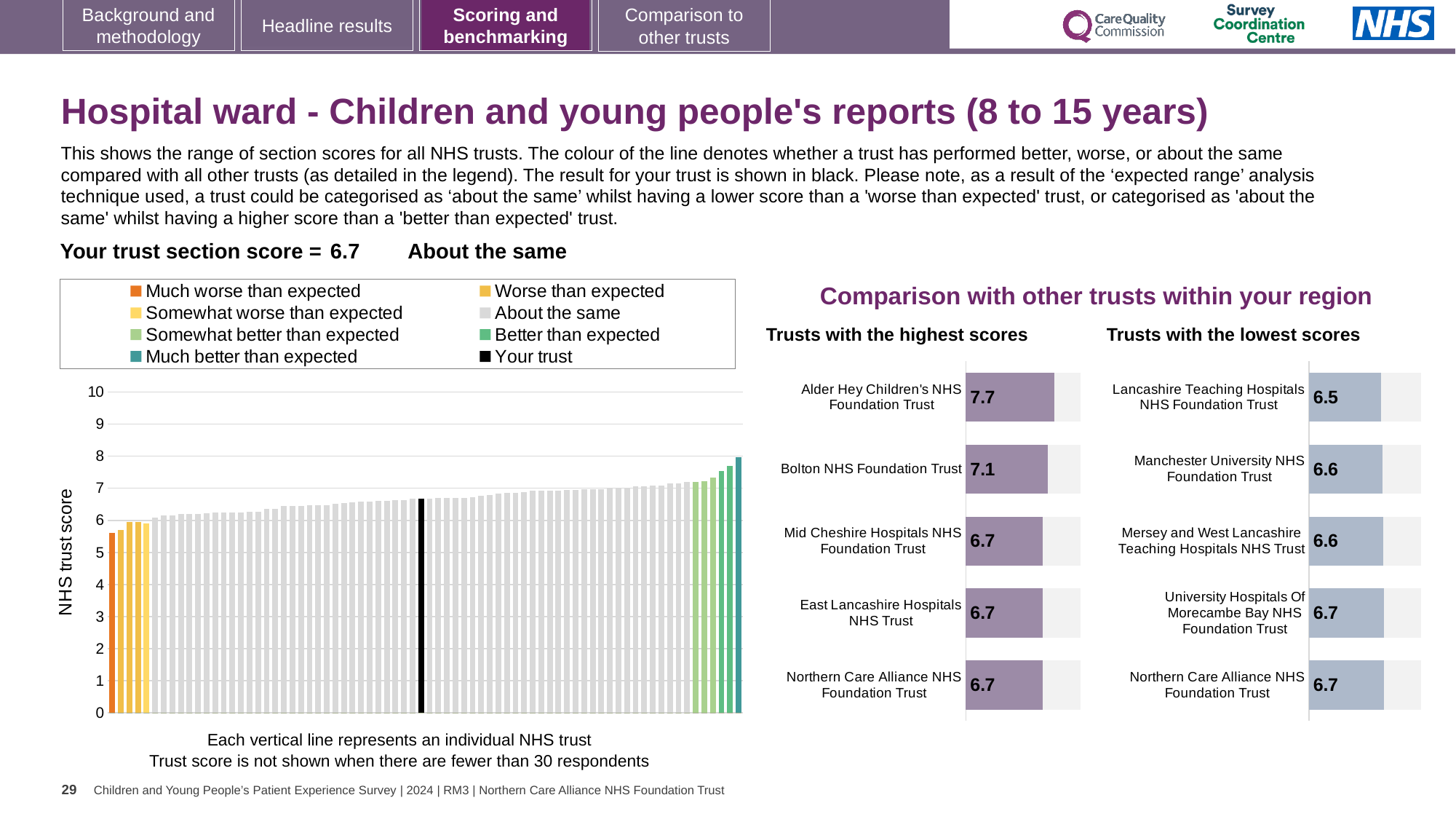
In the 'Trusts with the lowest scores' chart, what is the score for Manchester University NHS Foundation Trust? 6.6 In the 'Trusts with the highest scores' chart, what is the score for Alder Hey Children's NHS Foundation Trust? 7.7 In the large 'NHS trust score' chart on the left, is the value of the black bar (your trust) greater or less than 7? less How many trusts are shown in the 'Trusts with the highest scores' chart? 5 What type of chart is the large 'NHS trust score' chart on the left? Bar chart Which is larger: the score for Bolton NHS Foundation Trust in the 'highest scores' chart or the score for Manchester University NHS Foundation Trust in the 'lowest scores' chart? Bolton NHS Foundation Trust In the 'Trusts with the lowest scores' chart, what is the score for Lancashire Teaching Hospitals NHS Foundation Trust? 6.5 In the 'Trusts with the highest scores' chart, which trust has the highest score? Alder Hey Children's NHS Foundation Trust In the 'Trusts with the lowest scores' chart, what is the difference between the scores of Northern Care Alliance NHS Foundation Trust and Lancashire Teaching Hospitals NHS Foundation Trust? 0.2 In the 'Trusts with the highest scores' chart, what is the difference between the scores of Alder Hey Children's NHS Foundation Trust and Bolton NHS Foundation Trust? 0.6 In the 'Trusts with the highest scores' chart, what is the score for Bolton NHS Foundation Trust? 7.1 In the 'Trusts with the lowest scores' chart, which trust has the lowest score? Lancashire Teaching Hospitals NHS Foundation Trust